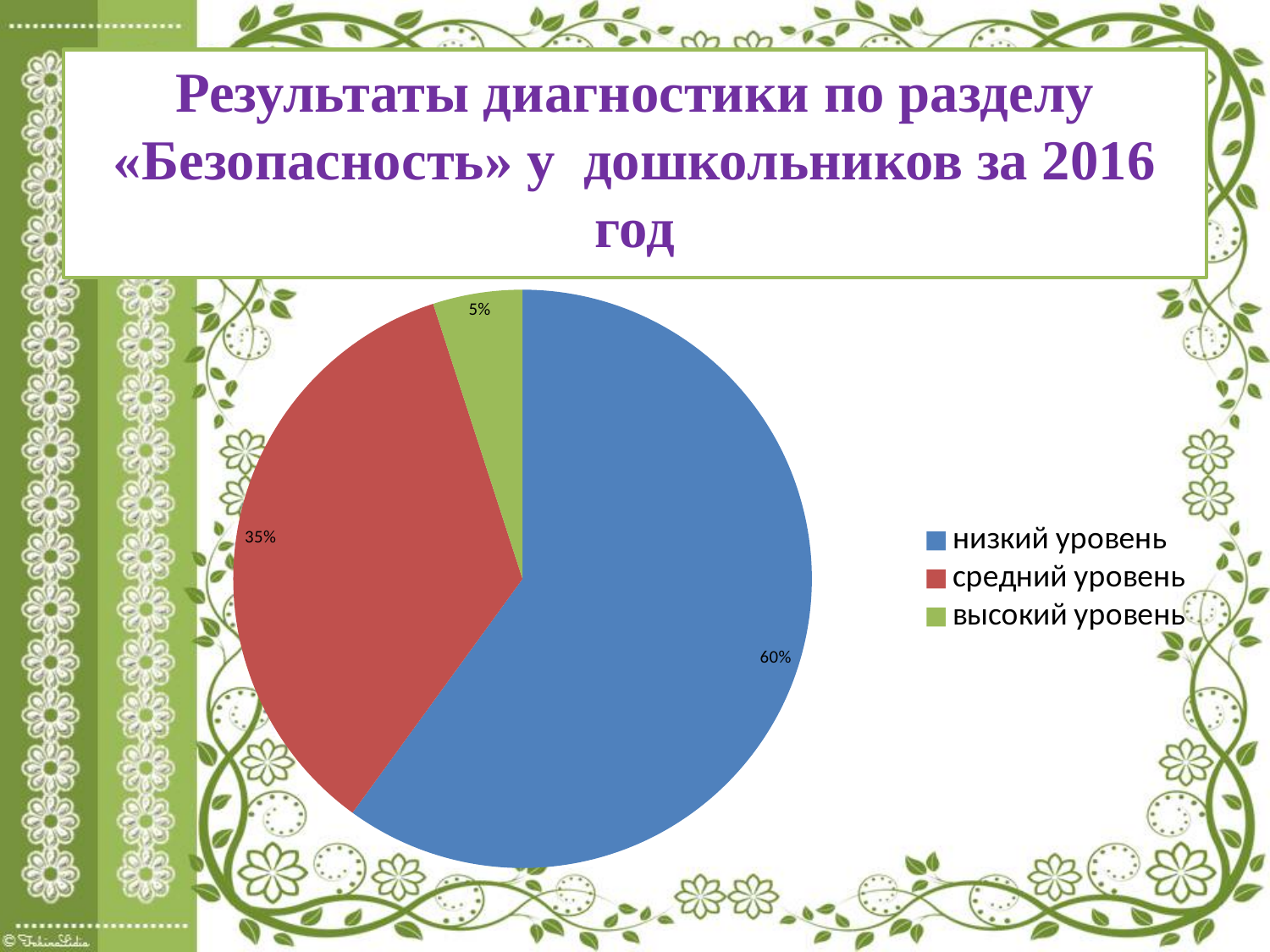
What is the difference between the values for средний уровень and высокий уровень? 30% What is the difference between the values for низкий уровень and средний уровень? 25% Which category has the smallest share of the pie? высокий уровень How many entries does the legend list? 3 How many categories does the pie chart have? 3 What is the value for средний уровень? 35% What colour is the slice for средний уровень? red Which is larger, the value for средний уровень or the value for высокий уровень? средний уровень What kind of chart is shown on the slide? pie chart Which category has the largest share of the pie? низкий уровень What is the value for высокий уровень? 5% What is the value for низкий уровень? 60%